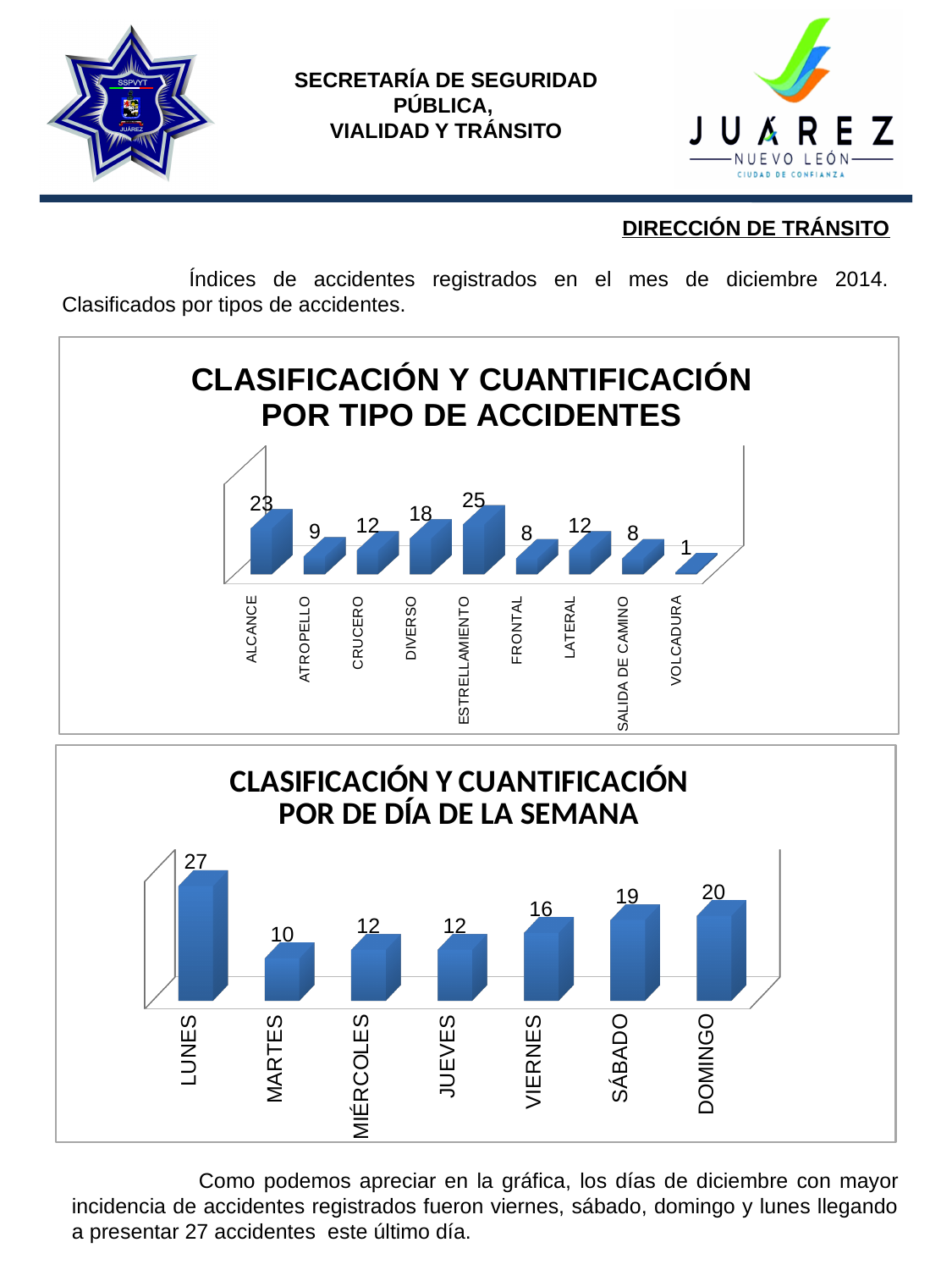
In the 'CLASIFICACIÓN Y CUANTIFICACIÓN POR TIPO DE ACCIDENTES' chart, what is the difference between ALCANCE and DIVERSO? 5 In the 'CLASIFICACIÓN Y CUANTIFICACIÓN POR TIPO DE ACCIDENTES' chart, which category has the lowest value? VOLCADURA In the 'CLASIFICACIÓN Y CUANTIFICACIÓN POR DE DÍA DE LA SEMANA' chart, what is the difference between DOMINGO and SÁBADO? 1 In the 'CLASIFICACIÓN Y CUANTIFICACIÓN POR DE DÍA DE LA SEMANA' chart, how many days are shown? 7 In the 'CLASIFICACIÓN Y CUANTIFICACIÓN POR TIPO DE ACCIDENTES' chart, which category has the highest value? ESTRELLAMIENTO In the 'CLASIFICACIÓN Y CUANTIFICACIÓN POR TIPO DE ACCIDENTES' chart, which is larger, CRUCERO or ATROPELLO? CRUCERO What kind of chart is the 'CLASIFICACIÓN Y CUANTIFICACIÓN POR DE DÍA DE LA SEMANA' chart? Bar chart In the 'CLASIFICACIÓN Y CUANTIFICACIÓN POR DE DÍA DE LA SEMANA' chart, what is the value for LUNES? 27 In the 'CLASIFICACIÓN Y CUANTIFICACIÓN POR DE DÍA DE LA SEMANA' chart, which day has the lowest value? MARTES In the 'CLASIFICACIÓN Y CUANTIFICACIÓN POR TIPO DE ACCIDENTES' chart, how many categories are shown? 9 In the 'CLASIFICACIÓN Y CUANTIFICACIÓN POR DE DÍA DE LA SEMANA' chart, do the values rise or fall from JUEVES to DOMINGO? Rise In the 'CLASIFICACIÓN Y CUANTIFICACIÓN POR TIPO DE ACCIDENTES' chart, what is the value for ESTRELLAMIENTO? 25